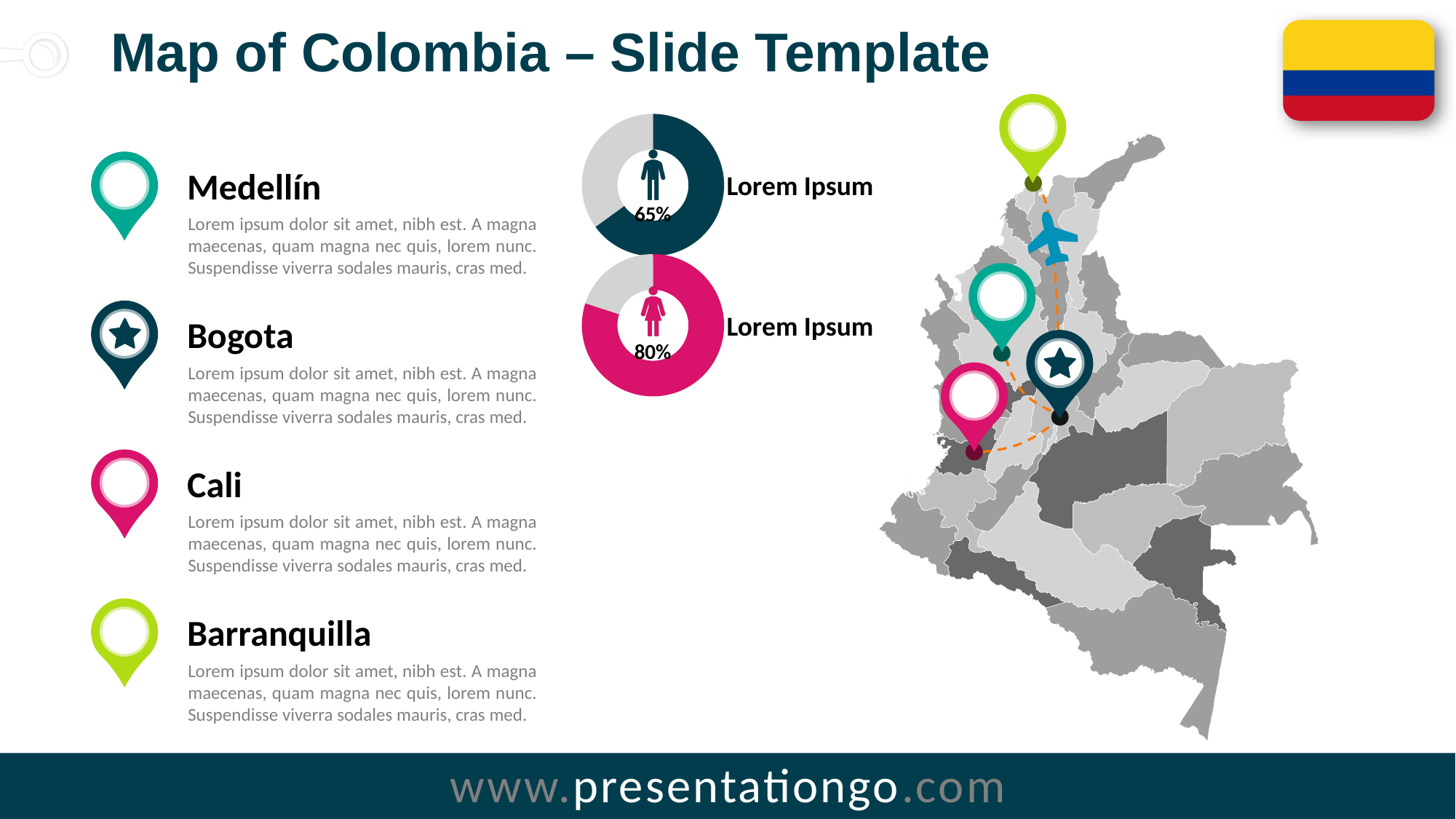
What share of the top donut chart is not filled by the dark teal segment? 35% What label text appears next to each of the two donut charts? Lorem Ipsum What percentage is shown in the bottom donut chart with the female figure icon? 80% Is the value in the bottom donut chart with the female icon greater or less than 75%? greater Is the value in the top donut chart with the male icon greater or less than 50%? greater What share of the bottom donut chart is not filled by the pink segment? 20% What kind of chart is used to display the 65% and 80% values? Donut chart What colour is the filled portion of the bottom donut chart showing 80%? Pink (magenta) What is the difference between the percentage in the bottom donut chart (80%) and the top donut chart (65%)? 15% How many donut charts are shown on the slide? 2 Which donut chart shows the larger percentage, the one with the male icon or the one with the female icon? The one with the female icon What percentage is shown in the top donut chart with the male figure icon? 65%